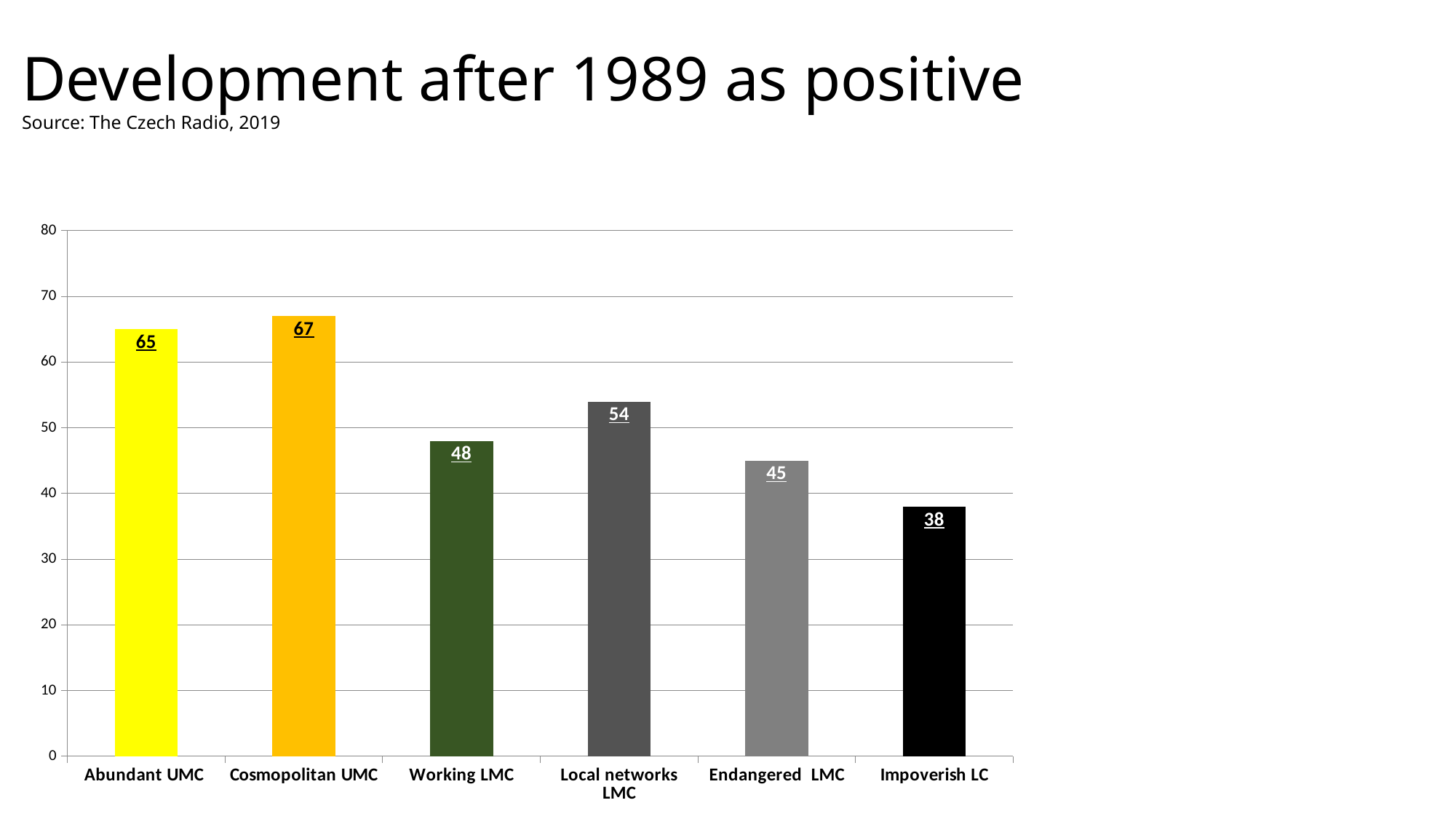
Which is larger, the value for Working LMC or the value for Endangered LMC? Working LMC What is the difference between the values for Cosmopolitan UMC and Working LMC? 19 What is the title of the chart? Development after 1989 as positive What is the value for Local networks LMC? 54 What colour is the bar for Cosmopolitan UMC? orange What kind of chart is shown on the slide? bar chart Which category has the highest value? Cosmopolitan UMC What is the value for Impoverish LC? 38 What is the value for Abundant UMC? 65 Which category has the lowest value? Impoverish LC Is the value for Endangered LMC greater or less than 50? less How many categories are shown on the chart? 6